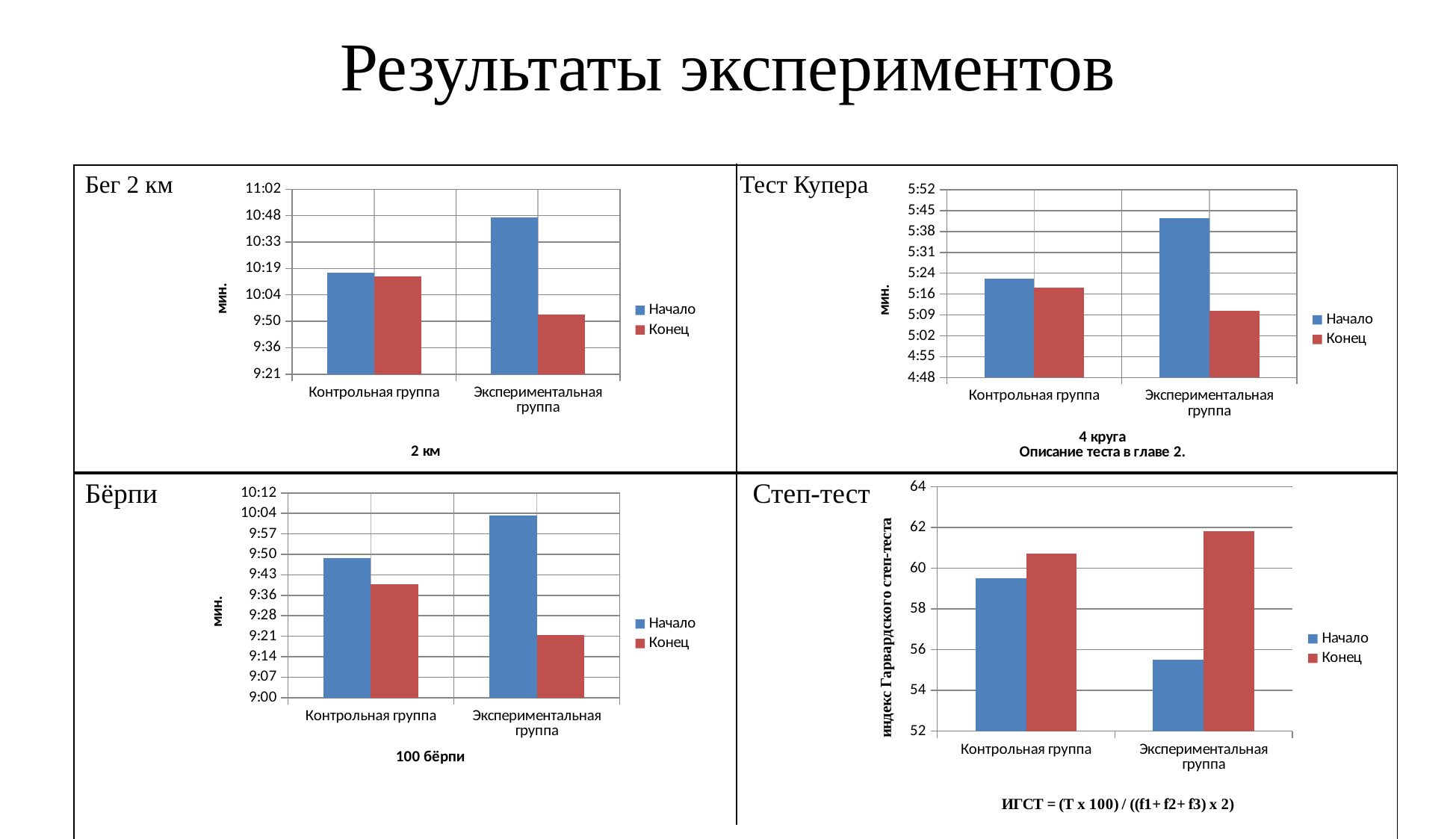
How many groups are shown on the x axis of the Бёрпи chart? 2 In the Бёрпи chart, is the Конец value for Экспериментальная группа greater or less than 9:28? less In the Бег 2 км chart, is the Конец value for Экспериментальная группа greater or less than 10:04? less In the Степ-тест chart, which group has the higher Конец value? Экспериментальная группа In the Степ-тест chart, is the Начало value for Экспериментальная группа greater or less than 56? less In the Бёрпи chart, which series is higher for Контрольная группа, Начало or Конец? Начало What is the y-axis label of the Степ-тест chart? индекс Гарвардского степ-теста How many series does the legend of the Тест Купера chart list? 2 What kind of chart is the Степ-тест chart? bar chart